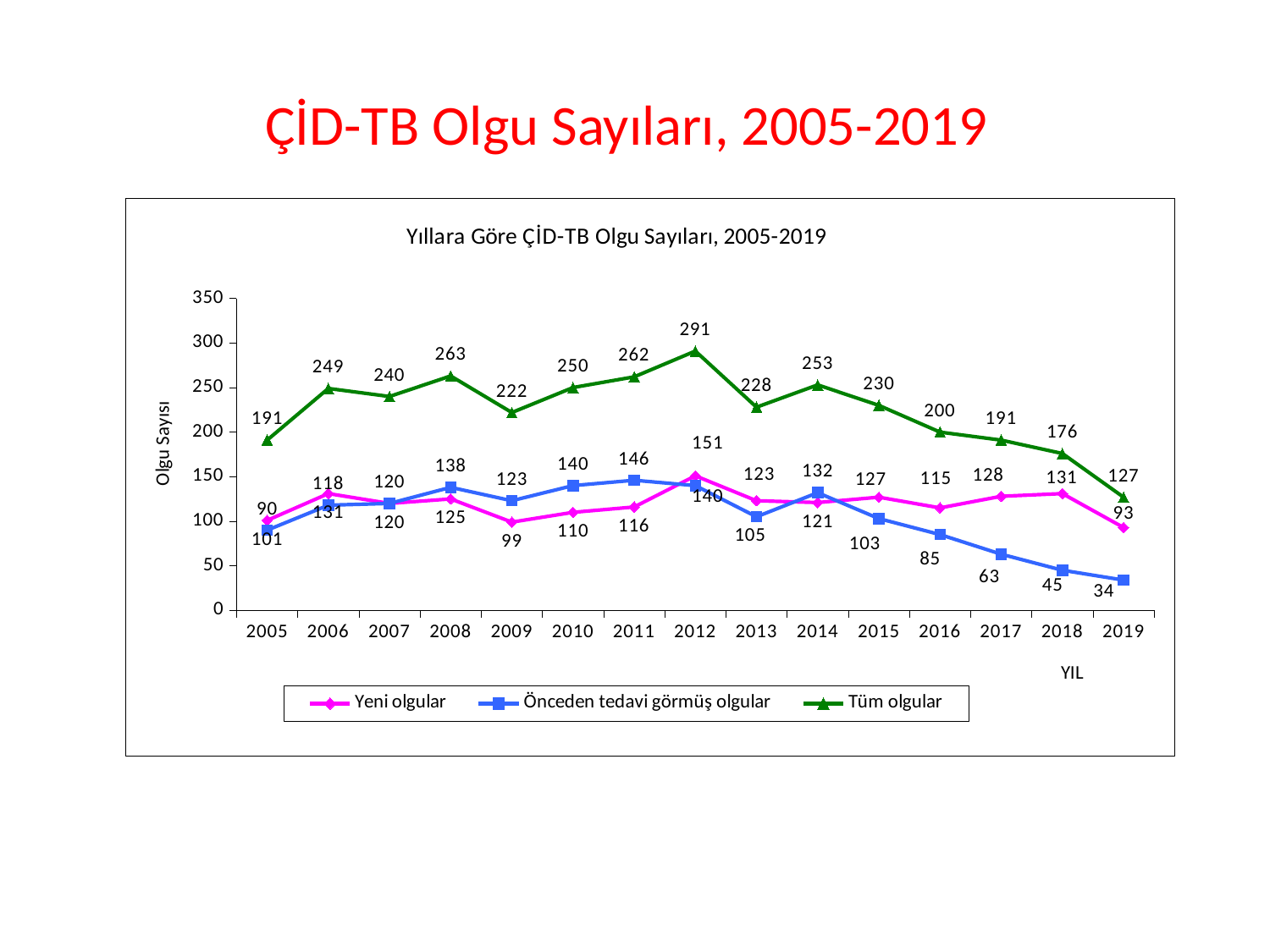
What is the title of the chart inside the plot area? Yıllara Göre ÇİD-TB Olgu Sayıları, 2005-2019 Does Önceden tedavi görmüş olgular rise or fall from 2014 to 2019? Fall What is the value for Önceden tedavi görmüş olgular in 2019? 34 In which year is Tüm olgular highest? 2012 What kind of chart is shown? Line chart What is the value for Yeni olgular in 2009? 99 In which year is Önceden tedavi görmüş olgular lowest? 2019 How many years are shown on the x axis? 15 How many series does the legend list? 3 What is the value for Tüm olgular in 2012? 291 Which is larger in 2017: Yeni olgular or Önceden tedavi görmüş olgular? Yeni olgular What is the difference between Tüm olgular in 2012 and in 2019? 164